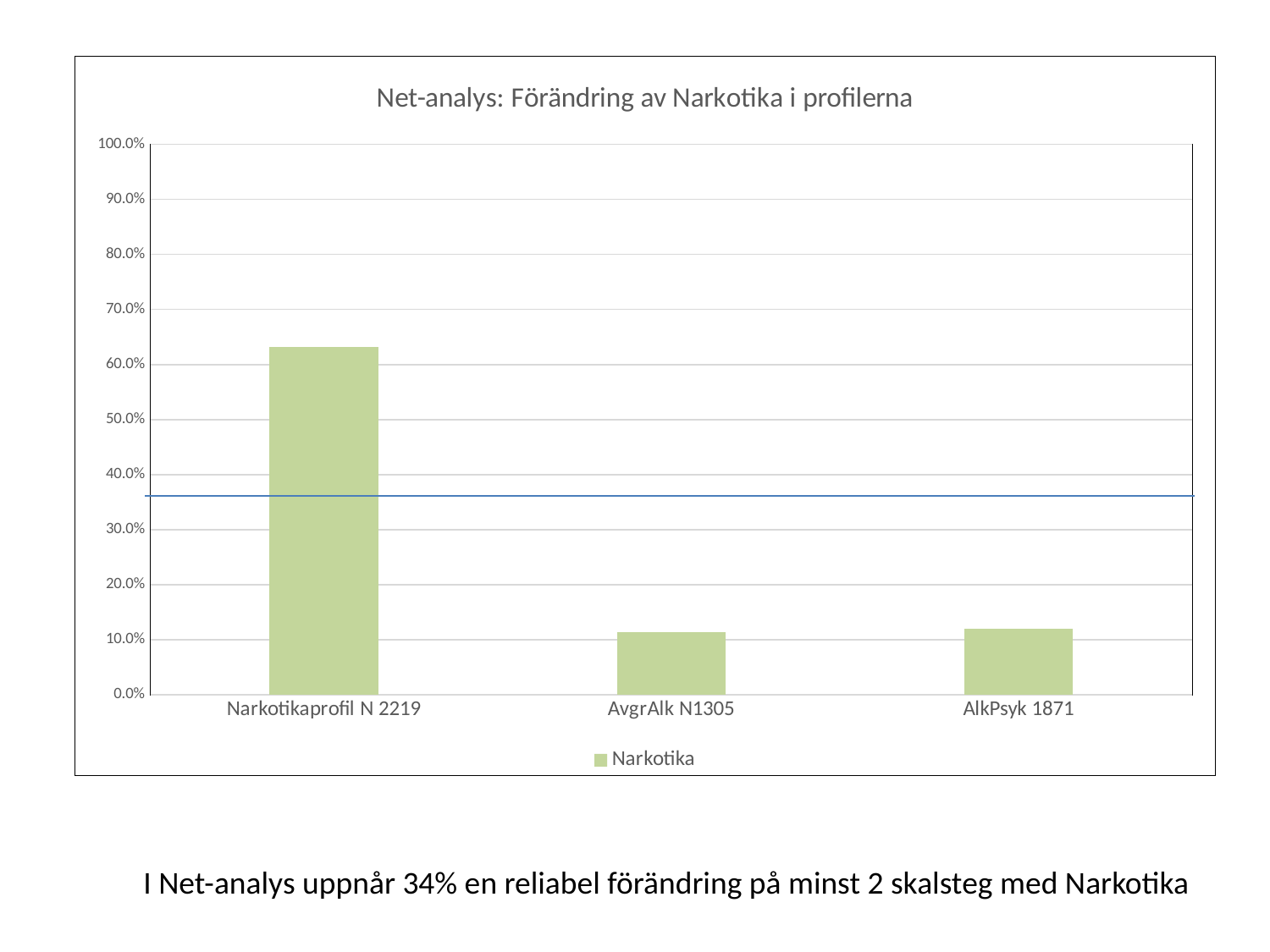
Which is larger, the value for Narkotikaprofil N 2219 or the value for AvgrAlk N1305? Narkotikaprofil N 2219 Is the value for Narkotikaprofil N 2219 greater or less than 70.0%? less Which category has the highest value in the chart? Narkotikaprofil N 2219 What is the title of the chart? Net-analys: Förändring av Narkotika i profilerna Is the value for AlkPsyk 1871 greater or less than 10.0%? greater How many categories are shown on the x axis of the chart? 3 Is the value for Narkotikaprofil N 2219 greater or less than 60.0%? greater What type of chart is shown on the slide? bar chart Which is larger, the value for AlkPsyk 1871 or the value for Narkotikaprofil N 2219? Narkotikaprofil N 2219 How many series does the chart legend list? 1 What series name is shown in the chart legend? Narkotika